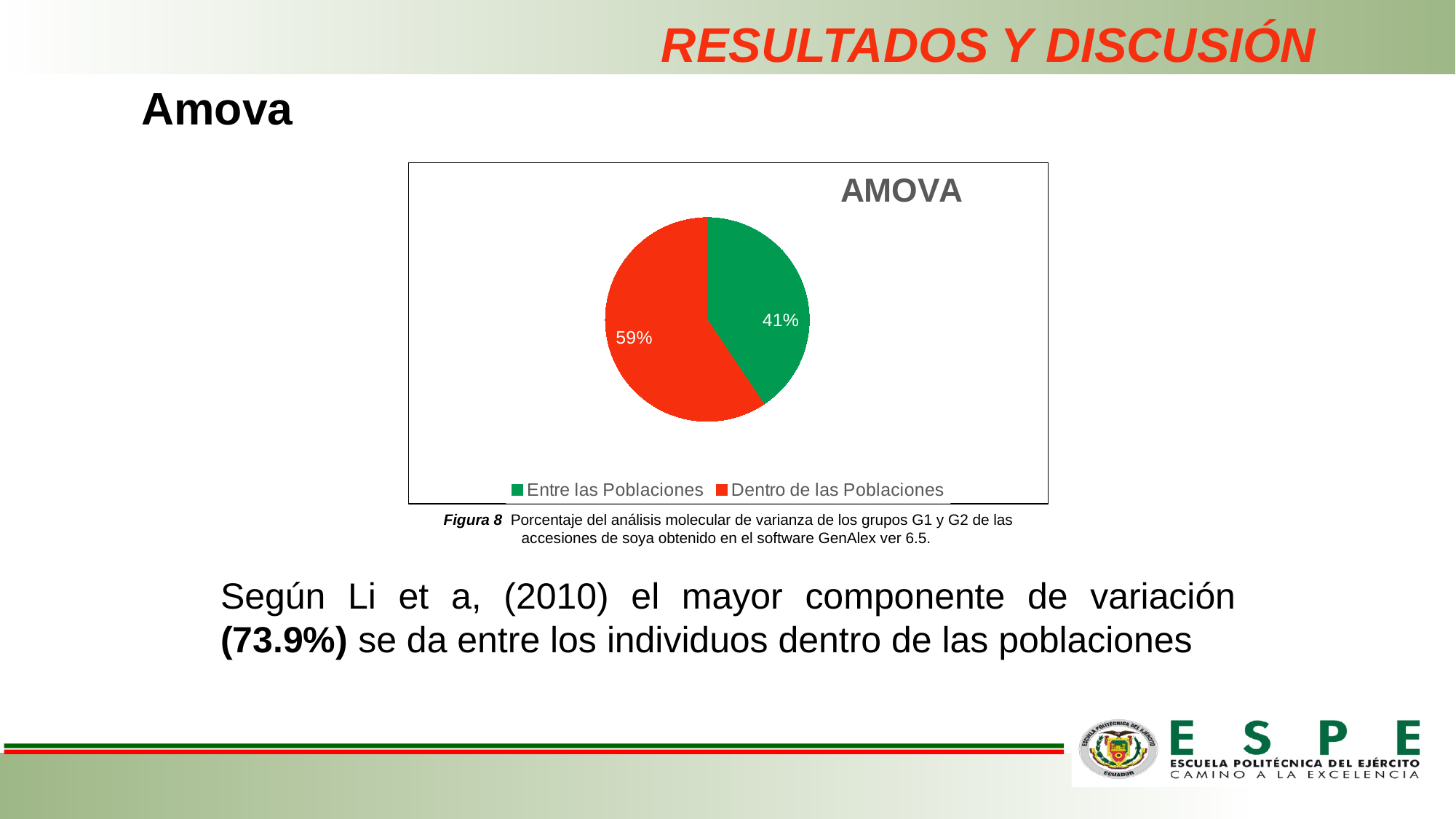
What is the difference in percentage points between Dentro de las Poblaciones and Entre las Poblaciones? 18 What percentage is shown for Entre las Poblaciones? 41% How many entries does the legend list? 2 How many slices does the pie chart have? 2 Which is larger, Entre las Poblaciones or Dentro de las Poblaciones? Dentro de las Poblaciones What is the title of the chart? AMOVA What percentage is shown for Dentro de las Poblaciones? 59% What kind of chart is shown on the slide? pie chart Which slice of the pie is the largest? Dentro de las Poblaciones What share of the pie does Entre las Poblaciones represent? 41% What colour is the slice for Dentro de las Poblaciones? red Which slice of the pie is the smallest? Entre las Poblaciones